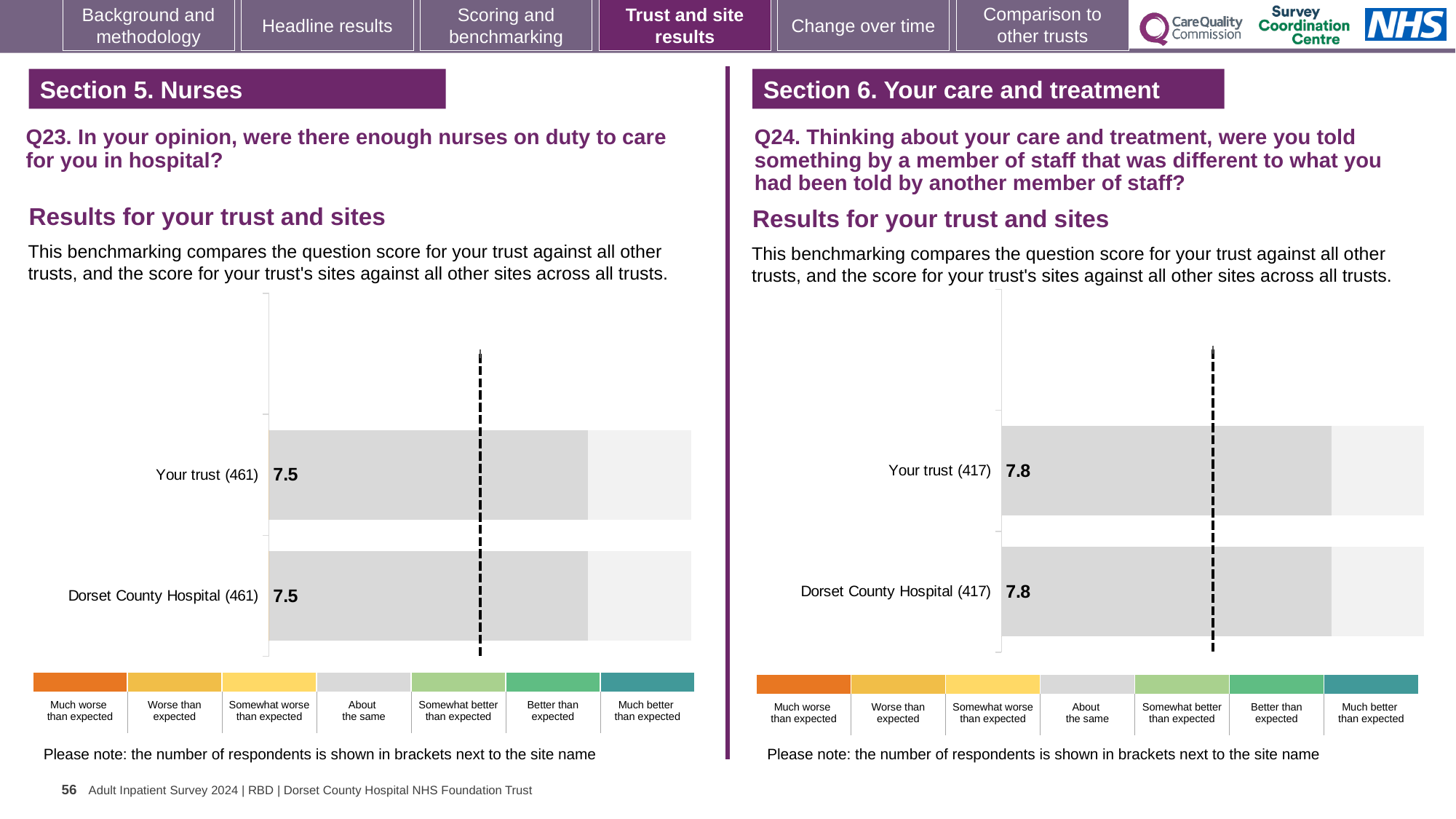
In the Q24 chart on the right, what is the score for Dorset County Hospital? 7.8 In the Q23 chart on the left, what is the score for Dorset County Hospital? 7.5 How many categories does the colour key below the Q23 chart on the left list? 7 In the Q24 chart on the right, how many respondents are shown in brackets for Dorset County Hospital? 417 In the Q24 chart on the right, what is the score for Your trust? 7.8 In the Q23 chart on the left, how many respondents are shown in brackets for Your trust? 461 What is the difference between the Your trust score in the Q24 chart on the right and the Your trust score in the Q23 chart on the left? 0.3 What kind of chart is the Q23 chart on the left? Bar chart How many bars are plotted in the Q24 chart on the right? 2 How many bars are plotted in the Q23 chart on the left? 2 In the Q23 chart on the left, what is the score for Your trust? 7.5 In the Q24 chart on the right, which category does the colour key label for the dark grey band in the middle? About the same